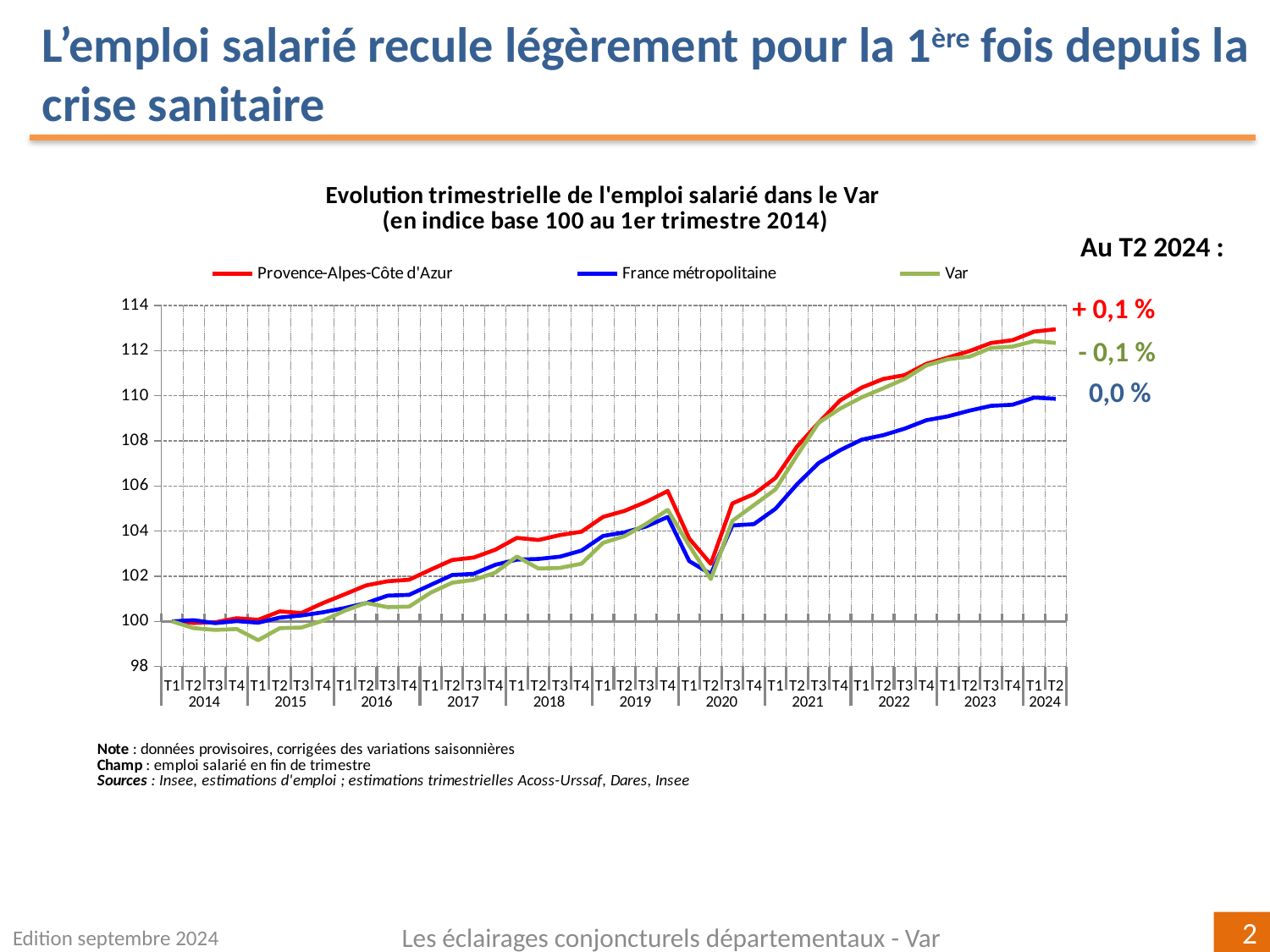
What is the title of the chart? Evolution trimestrielle de l'emploi salarié dans le Var (en indice base 100 au 1er trimestre 2014) What kind of chart is shown on the slide? Line chart How many series does the legend list? 3 Overall, do the values for France métropolitaine rise or fall from T1 2014 to T2 2024? Rise Which series has the lowest value at T2 2024? France métropolitaine Is the value for Provence-Alpes-Côte d'Azur at T2 2024 greater or less than 112? greater Is the value for Var at T1 2015 greater or less than 100? less According to the annotation for T2 2024, what is the change shown for Provence-Alpes-Côte d'Azur? + 0,1 % Which series has the highest value at T2 2024? Provence-Alpes-Côte d'Azur According to the annotation for T2 2024, what is the change shown for France métropolitaine? 0,0 % Which series is plotted in red? Provence-Alpes-Côte d'Azur According to the annotation for T2 2024, what is the change shown for Var? - 0,1 %